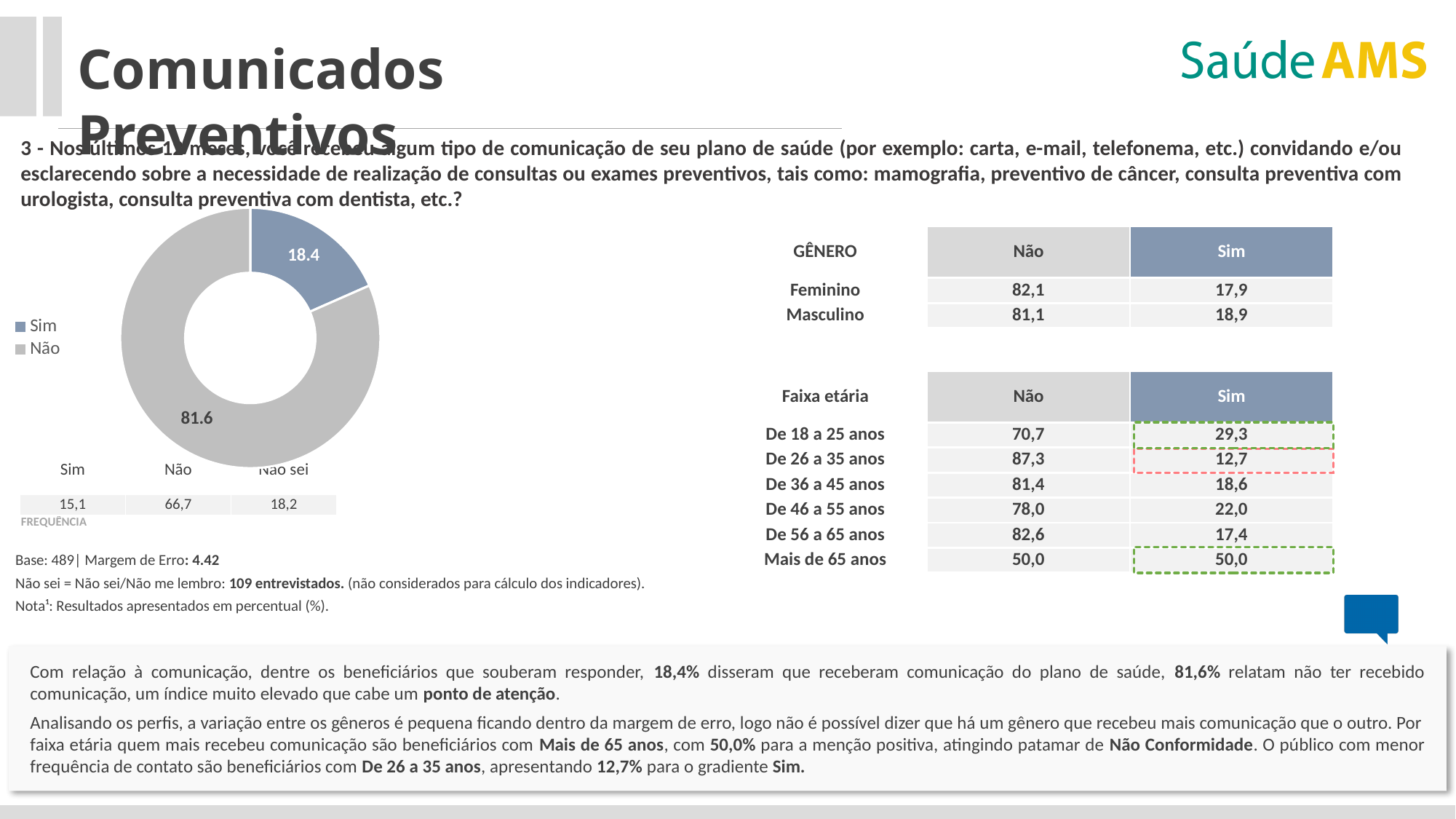
Which category has the largest slice in the donut chart? Não What colour is the Não slice in the donut chart? Grey Which category has the smallest slice in the donut chart? Sim How many slices does the donut chart have? 2 What value is shown for the Sim slice of the donut chart? 18.4 How many entries does the legend of the donut chart list? 2 What colour is the Sim slice in the donut chart? Blue What type of chart is shown on the left of the slide? Pie (donut) chart What is the difference between the Não and Sim values in the donut chart? 63.2 In the donut chart, which is larger: Sim or Não? Não What share of the donut chart does the Sim slice represent? 18.4 What value is shown for the Não slice of the donut chart? 81.6